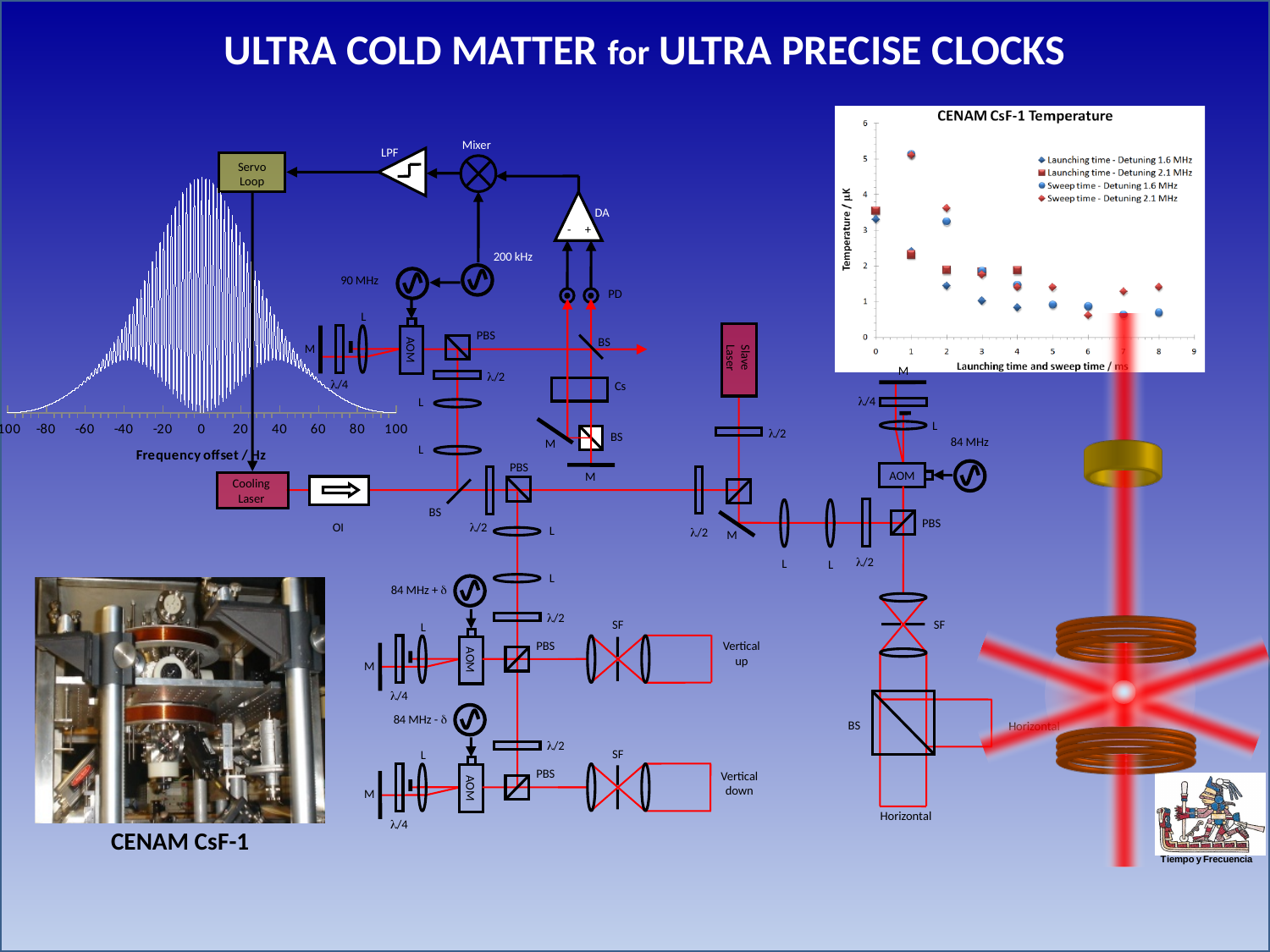
In the CENAM CsF-1 Temperature chart, which is larger at 2 ms: the value for Sweep time - Detuning 1.6 MHz or the value for Launching time - Detuning 1.6 MHz? Sweep time - Detuning 1.6 MHz In the CENAM CsF-1 Temperature chart, is the value for Sweep time - Detuning 1.6 MHz at 1 ms greater or less than 4? greater In the CENAM CsF-1 Temperature chart, what is the label of the vertical axis? Temperature / µK In the CENAM CsF-1 Temperature chart, how many series does the legend list? 4 In the CENAM CsF-1 Temperature chart, is the value for Sweep time - Detuning 2.1 MHz at 3 ms greater or less than 3? less What is the title of the chart in the upper right of the slide? CENAM CsF-1 Temperature In the CENAM CsF-1 Temperature chart, is the value for Sweep time - Detuning 1.6 MHz at 8 ms greater or less than 2? less What kind of chart is the CENAM CsF-1 Temperature chart? scatter chart In the CENAM CsF-1 Temperature chart, do the temperature values generally rise or fall as launching time and sweep time increase? fall